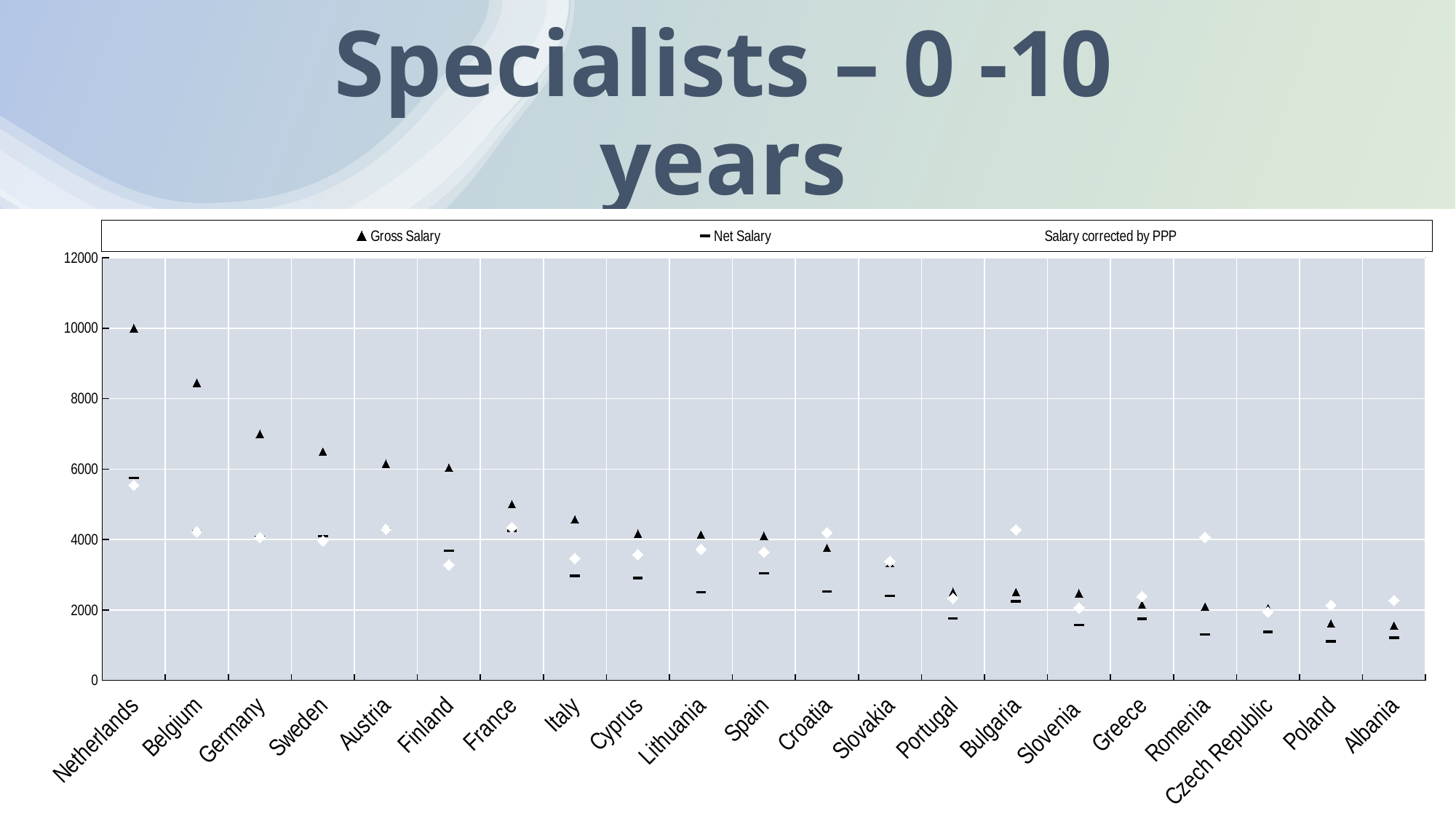
Do the Gross Salary values generally rise or fall from left to right along the x axis? fall Is the Salary corrected by PPP for Bulgaria greater or less than 4000? greater How many countries are shown on the x axis? 21 What is the title of the slide? Specialists – 0 -10 years Is the Gross Salary for Netherlands greater or less than 8000? greater Which series is shown with triangle markers? Gross Salary Which country has the highest Gross Salary? Netherlands Is the Net Salary for Finland greater or less than 4000? less Which is larger, the Gross Salary for Belgium or the Gross Salary for Sweden? Belgium How many series does the legend list? 3 Which country has the highest Salary corrected by PPP? Netherlands